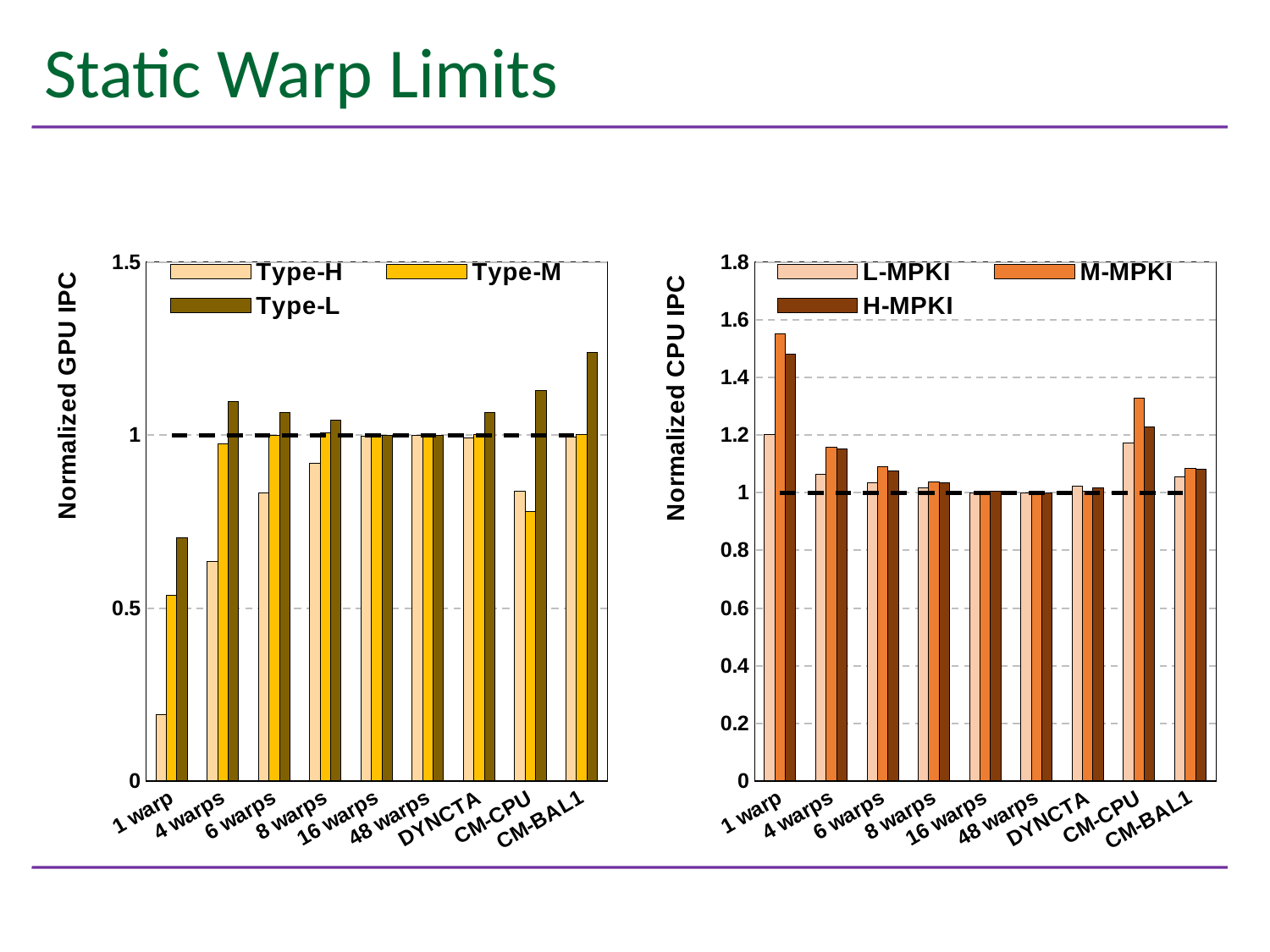
On the right chart (Normalized CPU IPC), for which category is the M-MPKI bar highest? 1 warp On the left chart (Normalized GPU IPC), for which category is the Type-H bar lowest? 1 warp On the left chart (Normalized GPU IPC), is the Type-H value for 1 warp greater or less than 0.5? less On the left chart (Normalized GPU IPC), what kind of chart is shown? bar chart On the left chart (Normalized GPU IPC), for which category is the Type-L bar highest? CM-BAL1 On the right chart (Normalized CPU IPC), is the M-MPKI value for 1 warp greater or less than 1.4? greater On the right chart (Normalized CPU IPC), for CM-CPU, which is larger: M-MPKI or L-MPKI? M-MPKI On the left chart (Normalized GPU IPC), is the Type-L value for CM-BAL1 greater or less than 1? greater On the left chart (Normalized GPU IPC), how many series does the legend list? 3 On the left chart (Normalized GPU IPC), for 1 warp, which is larger: Type-L or Type-H? Type-L On the right chart (Normalized CPU IPC), how many categories are shown on the x axis? 9 On the right chart (Normalized CPU IPC), which series does the legend list besides L-MPKI and M-MPKI? H-MPKI